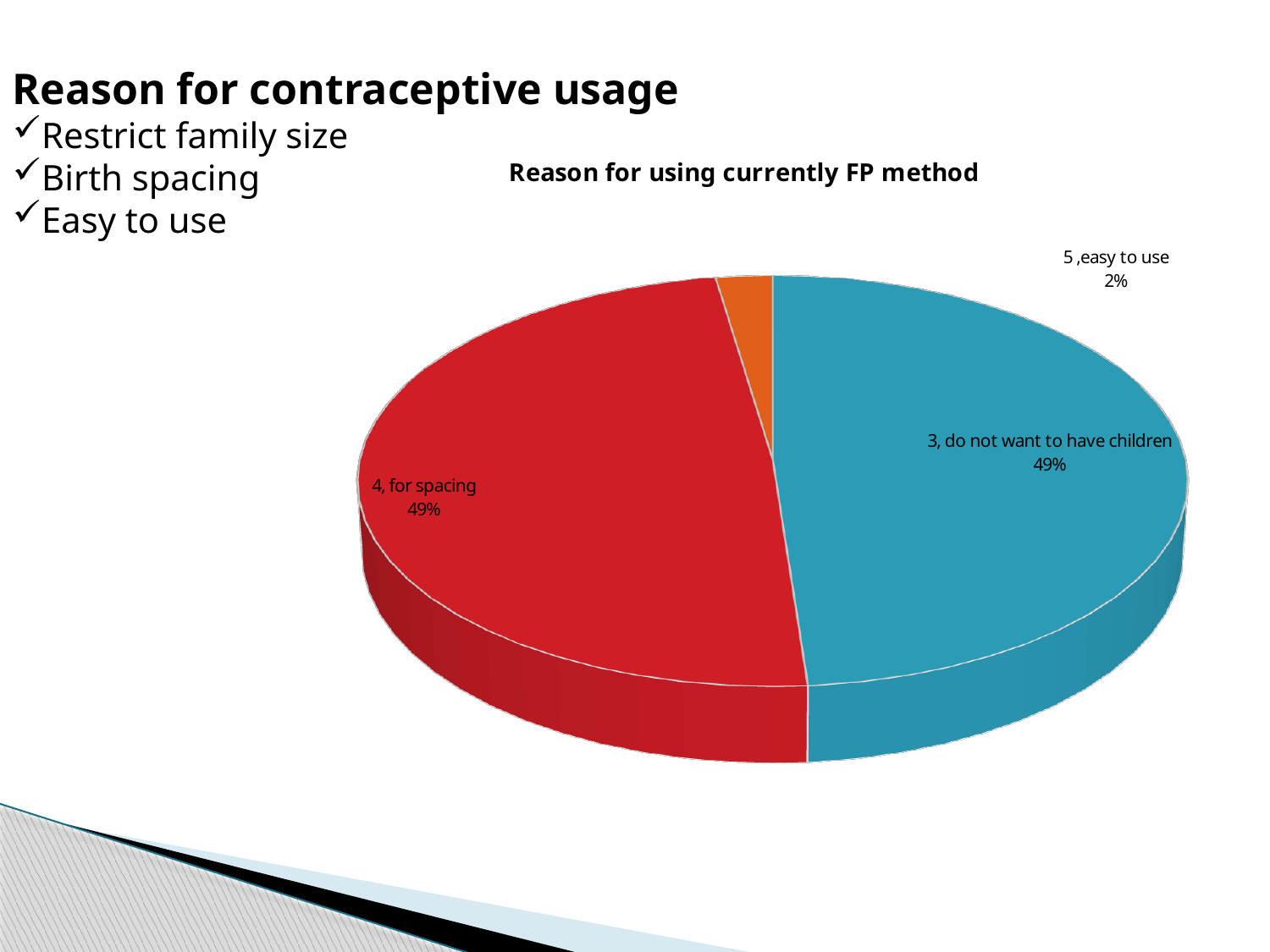
What colour is the "4, for spacing" slice? red What is the difference in percentage points between the "4, for spacing" slice and the "5 ,easy to use" slice? 47 What kind of chart is shown on the slide? pie chart What share of the pie is labelled "5 ,easy to use"? 2% Which slice of the pie is the smallest? 5 ,easy to use How many slices does the pie chart have? 3 Which is larger: the "3, do not want to have children" slice or the "5 ,easy to use" slice? 3, do not want to have children What share of the pie is labelled "4, for spacing"? 49% What is the combined share of the "3, do not want to have children" and "4, for spacing" slices? 98% What share of the pie is labelled "3, do not want to have children"? 49% What is the title of the chart? Reason for using currently FP method